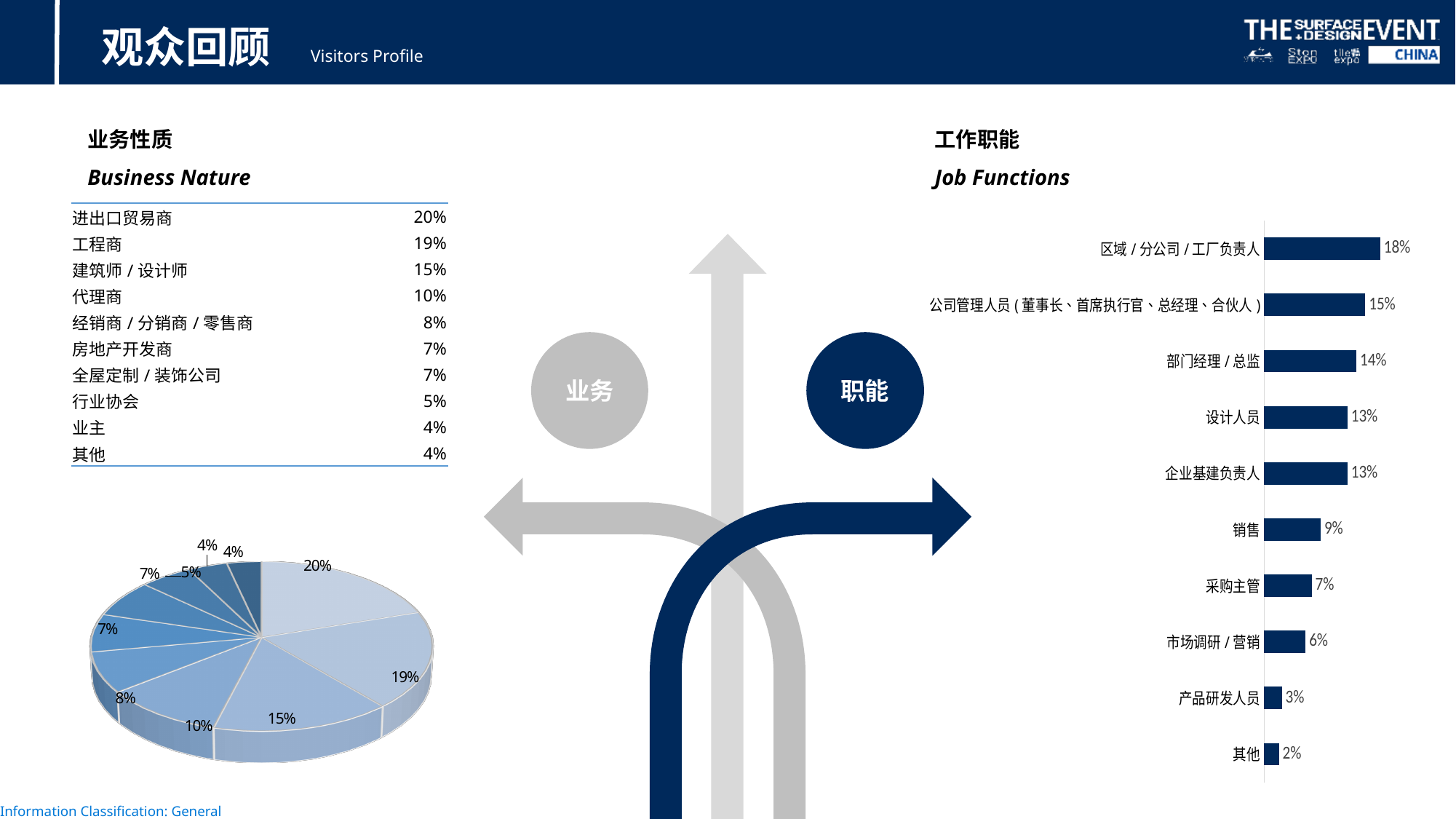
What kind of chart is the Business Nature chart at the bottom left? pie chart In the Business Nature pie chart, what is the value of the largest slice? 20% In the Job Functions bar chart, what is the value for 产品研发人员? 3% How many categories are shown in the Job Functions bar chart? 10 In the Job Functions bar chart, which category has the lowest value? 其他 In the Job Functions bar chart, which is larger: 设计人员 or 市场调研 / 营销? 设计人员 How many slices does the Business Nature pie chart have? 10 What kind of chart is the Job Functions chart? bar chart In the Job Functions bar chart, what is the value for 销售? 9% In the Job Functions bar chart, which category has the highest value? 区域 / 分公司 / 工厂负责人 In the Job Functions bar chart, what is the difference between 区域 / 分公司 / 工厂负责人 and 采购主管? 11% In the Job Functions bar chart, what is the value for 部门经理 / 总监? 14%